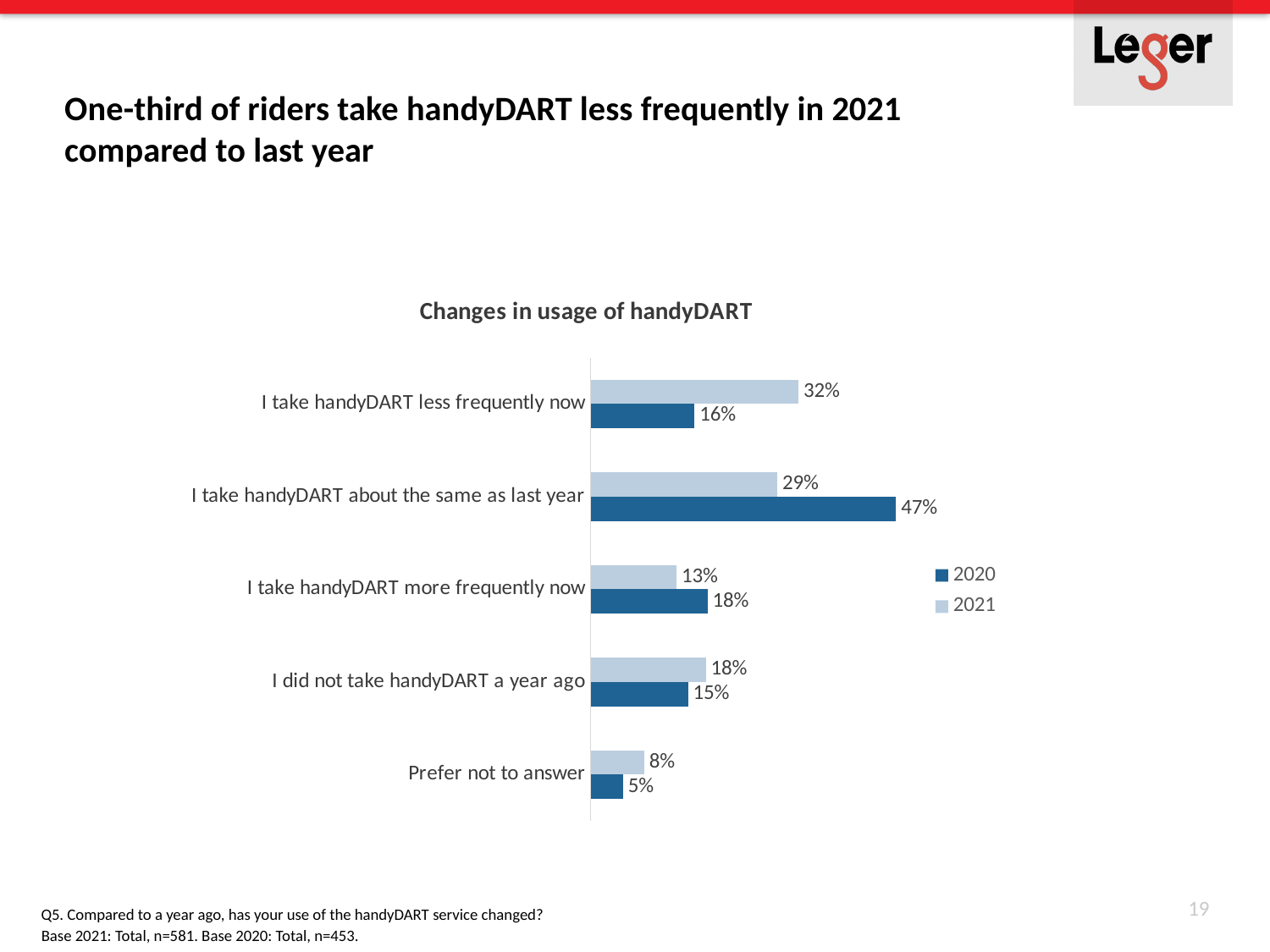
What percentage of riders said "I take handyDART about the same as last year" in 2020? 47% What is the 2020 value for "Prefer not to answer"? 5% What is the 2021 value for "I take handyDART more frequently now"? 13% Which category has the lowest value in 2021? Prefer not to answer What is the difference between the 2020 and 2021 values for "I take handyDART about the same as last year"? 18% How many series does the legend list? 2 How many categories are shown in the chart? 5 Which category has the highest value in 2020? I take handyDART about the same as last year For "I did not take handyDART a year ago", which year has the larger value, 2020 or 2021? 2021 What type of chart is shown on the slide? Bar chart What is the difference between the 2021 and 2020 values for "I take handyDART less frequently now"? 16% What percentage of riders said "I take handyDART less frequently now" in 2021? 32%